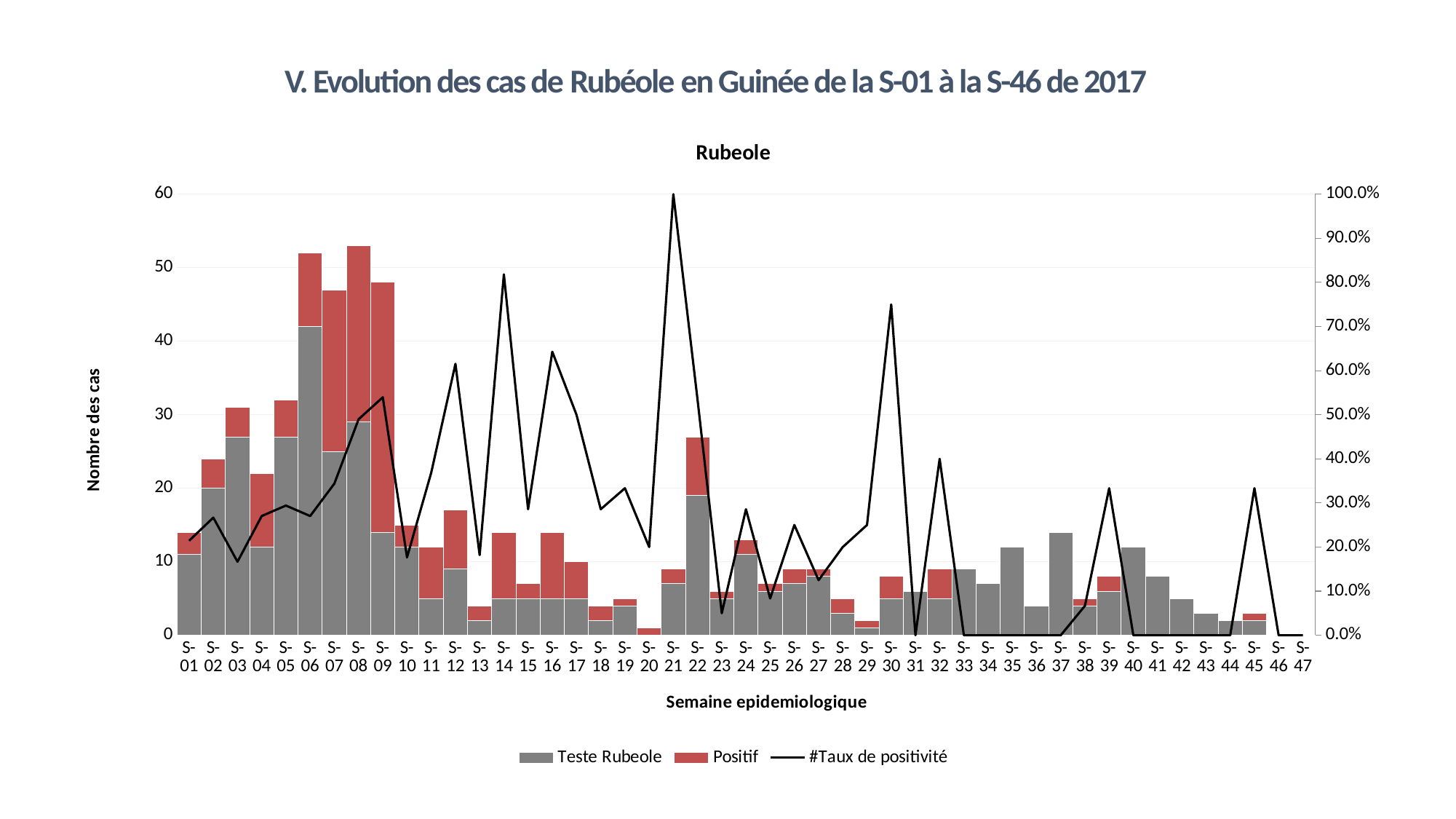
What are the three series listed in the legend? Teste Rubeole, Positif, #Taux de positivité What is the value of #Taux de positivité in week S-21? 100.0% Is the total stacked bar for week S-06 greater or less than 50? greater Is the Teste Rubeole value for week S-37 greater or less than 20? less Which week has the larger total stacked bar, S-06 or S-22? S-06 Which week has the tallest Teste Rubeole (grey) bar? S-06 Is the #Taux de positivité value for week S-14 greater or less than 70.0%? greater What is the title of the x axis? Semaine epidemiologique Do the stacked bar totals rise or fall from week S-09 to week S-13? fall In which week does the #Taux de positivité line reach its highest value? S-21 What kind of chart is shown on the slide? A combined bar chart and line chart How many series does the legend list? 3